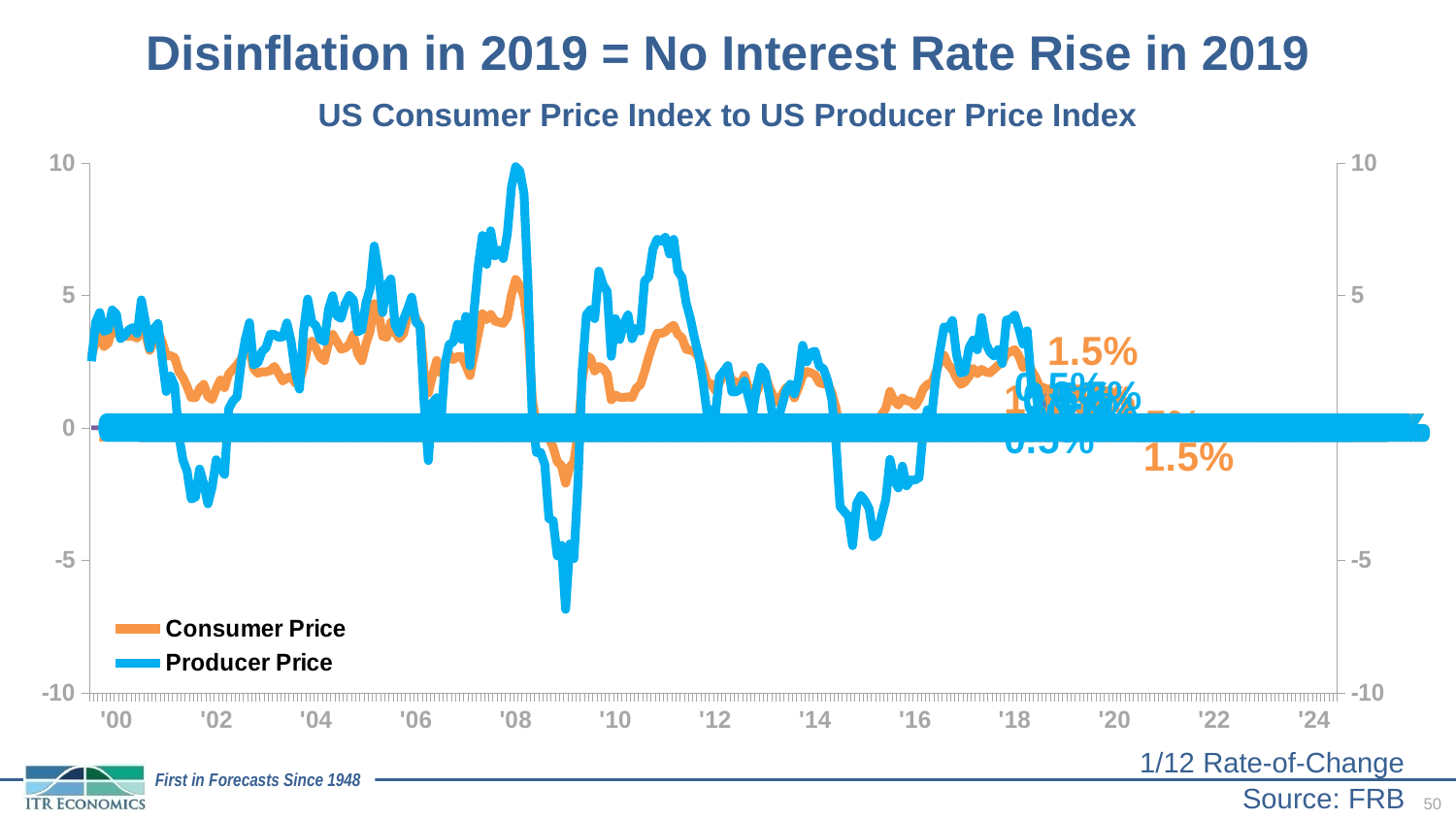
Which series falls to the lower value around 2009, Consumer Price or Producer Price? Producer Price What is the lowest value shown on the vertical axis? -10 What is the highest value shown on the vertical axis? 10 Does the Producer Price line rise or fall from its 2008 peak into 2009? fall What are the two series named in the legend? Consumer Price and Producer Price Is the peak value of the Producer Price line around 2008 greater or less than 5? greater Is the lowest value of the Producer Price line around 2009 greater or less than -5? less Which series reaches the higher peak around 2008, Consumer Price or Producer Price? Producer Price What is the title of the chart? US Consumer Price Index to US Producer Price Index What kind of chart is shown on the slide? line chart How many series does the legend list? 2 Is the Producer Price value around 2015 greater or less than 0? less